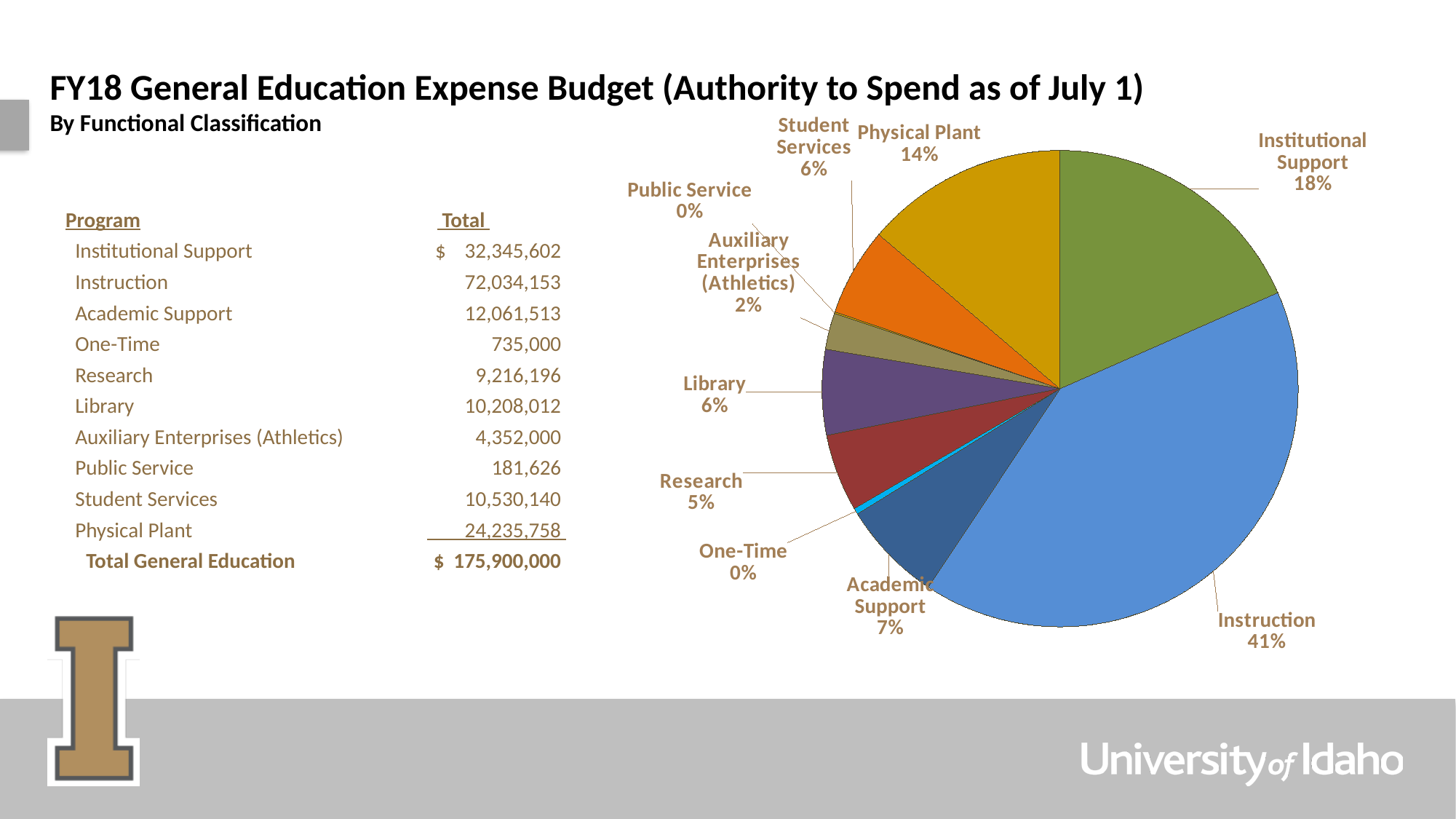
What percentage is shown for Academic Support in the pie chart? 7% Which category has the largest slice of the pie chart? Instruction What percentage is shown for Institutional Support in the pie chart? 18% Which slice is larger in the pie chart, Physical Plant or Student Services? Physical Plant What percentage of the pie does Instruction represent? 41% What percentage is shown for Auxiliary Enterprises (Athletics) in the pie chart? 2% How many slices (categories) does the pie chart have? 10 What colour is the Instruction slice in the pie chart? blue What percentage is shown for Physical Plant in the pie chart? 14% What kind of chart is shown on the slide? pie chart What is the difference in percentage points between Instruction and Institutional Support in the pie chart? 23% Which slice is larger in the pie chart, Library or Research? Library